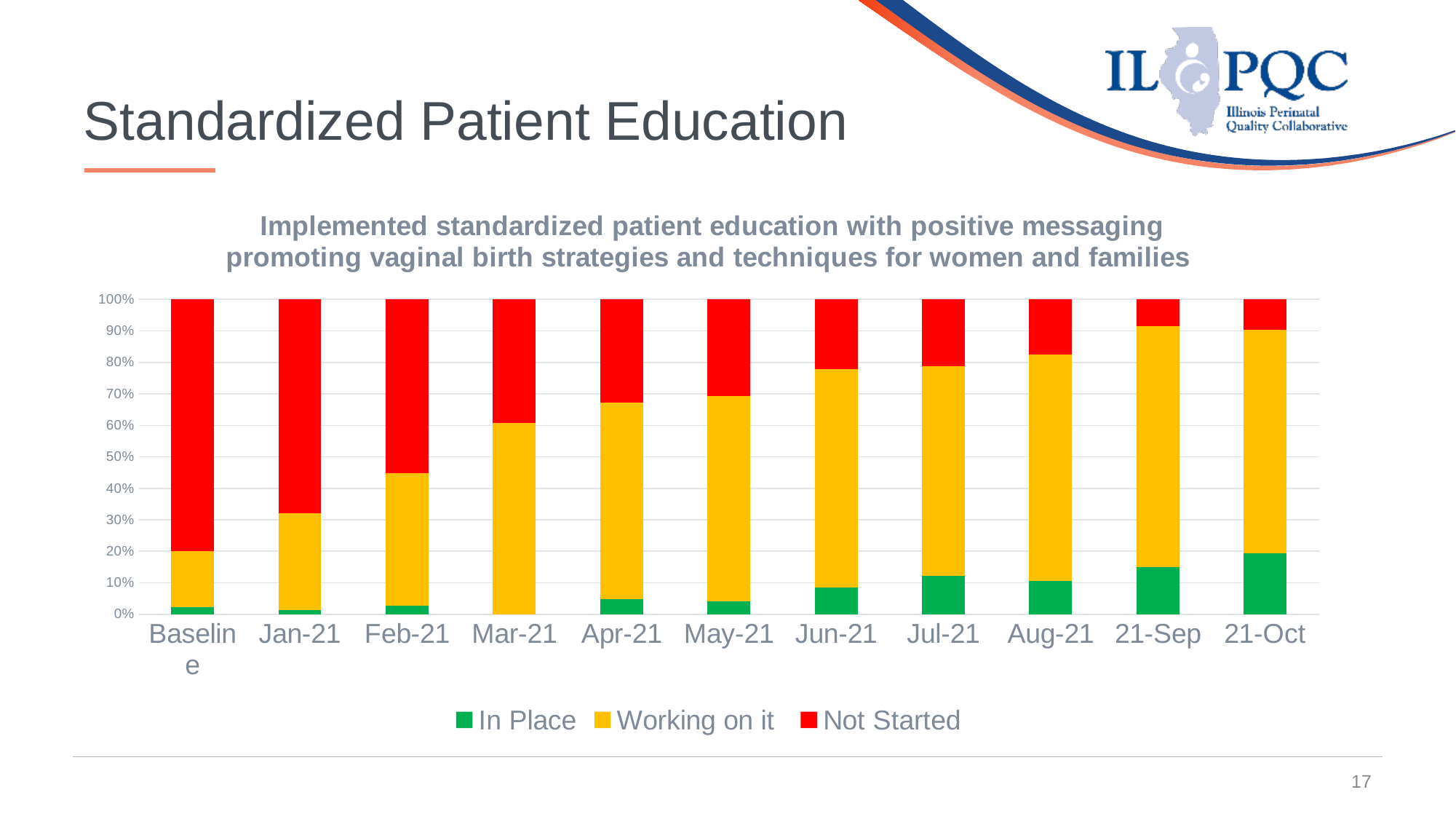
Is the 'Not Started' value for 21-Sep greater or less than 20%? less Which colour represents the 'Not Started' series in the chart? Red What kind of chart is shown on the slide? Stacked bar chart What are the three series named in the chart's legend? In Place, Working on it, Not Started Is the 'Not Started' value for Baseline greater or less than 50%? greater Is the 'In Place' value for 21-Oct greater or less than 10%? greater In which category is the 'In Place' share the highest? 21-Oct Does the 'Not Started' share generally rise or fall from Baseline to 21-Oct? Fall How many categories are shown along the x axis of the chart? 11 In which category is the 'Not Started' share the highest? Baseline How many series does the chart's legend list? 3 Is the 'Not Started' share larger for Baseline or for Jan-21? Baseline